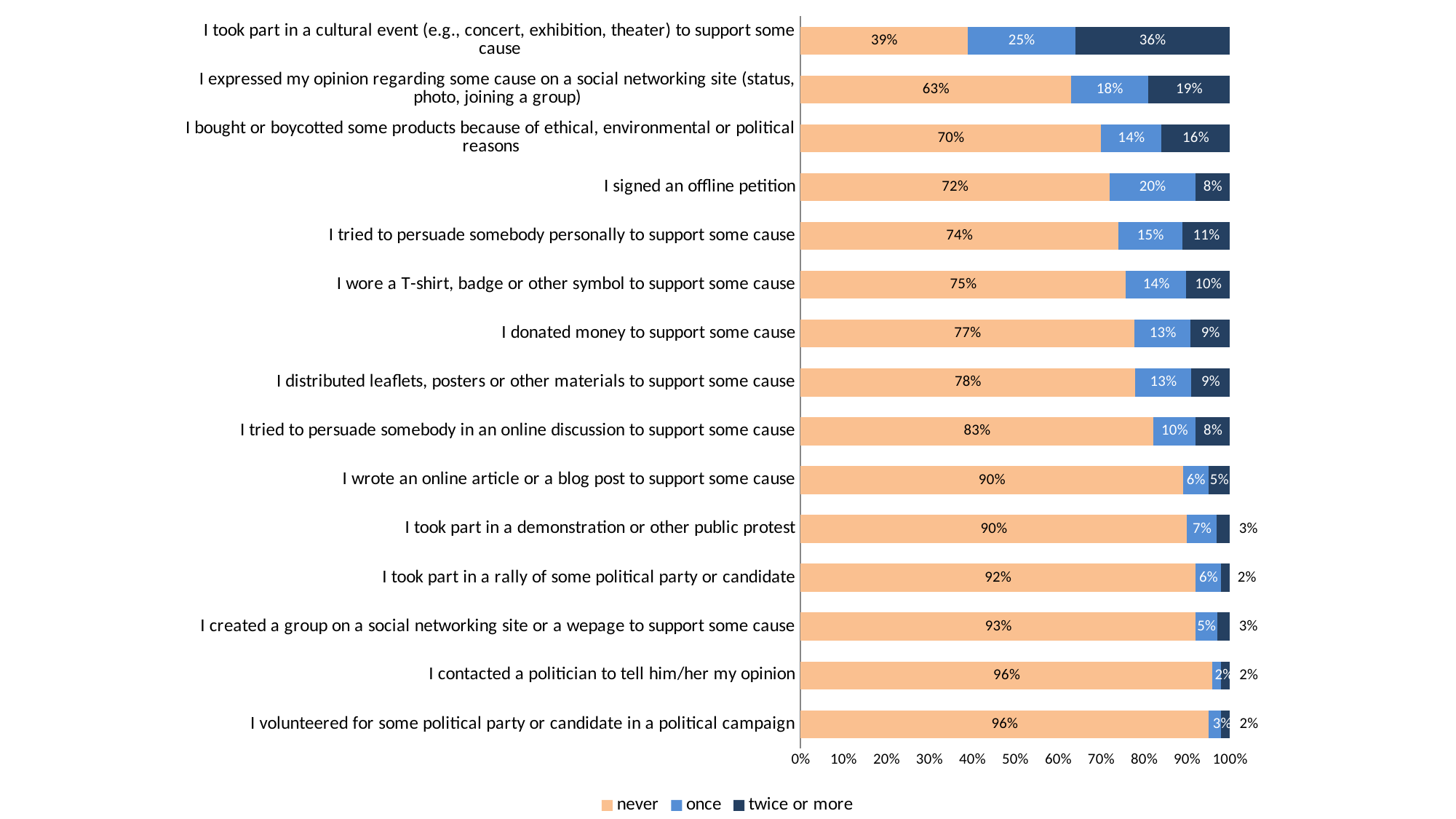
What is the "twice or more" value for "I took part in a cultural event (e.g., concert, exhibition, theater) to support some cause"? 36% Which has the larger "once" value: "I signed an offline petition" or "I tried to persuade somebody personally to support some cause"? I signed an offline petition How much higher is the "never" value for "I bought or boycotted some products because of ethical, environmental or political reasons" than for "I expressed my opinion regarding some cause on a social networking site (status, photo, joining a group)"? 7 percentage points What kind of chart is shown on the slide? Stacked bar chart What are the three legend entries of the chart? never, once, twice or more Which category has the highest "twice or more" value? I took part in a cultural event (e.g., concert, exhibition, theater) to support some cause Which category has the lowest "never" value? I took part in a cultural event (e.g., concert, exhibition, theater) to support some cause What is the total of the stacked bar for "I took part in a cultural event (e.g., concert, exhibition, theater) to support some cause"? 100% What is the "once" value for "I donated money to support some cause"? 13% How many series does the legend list? 3 How many categories (activities) are shown in the chart? 15 What percentage answered "never" for "I signed an offline petition"? 72%